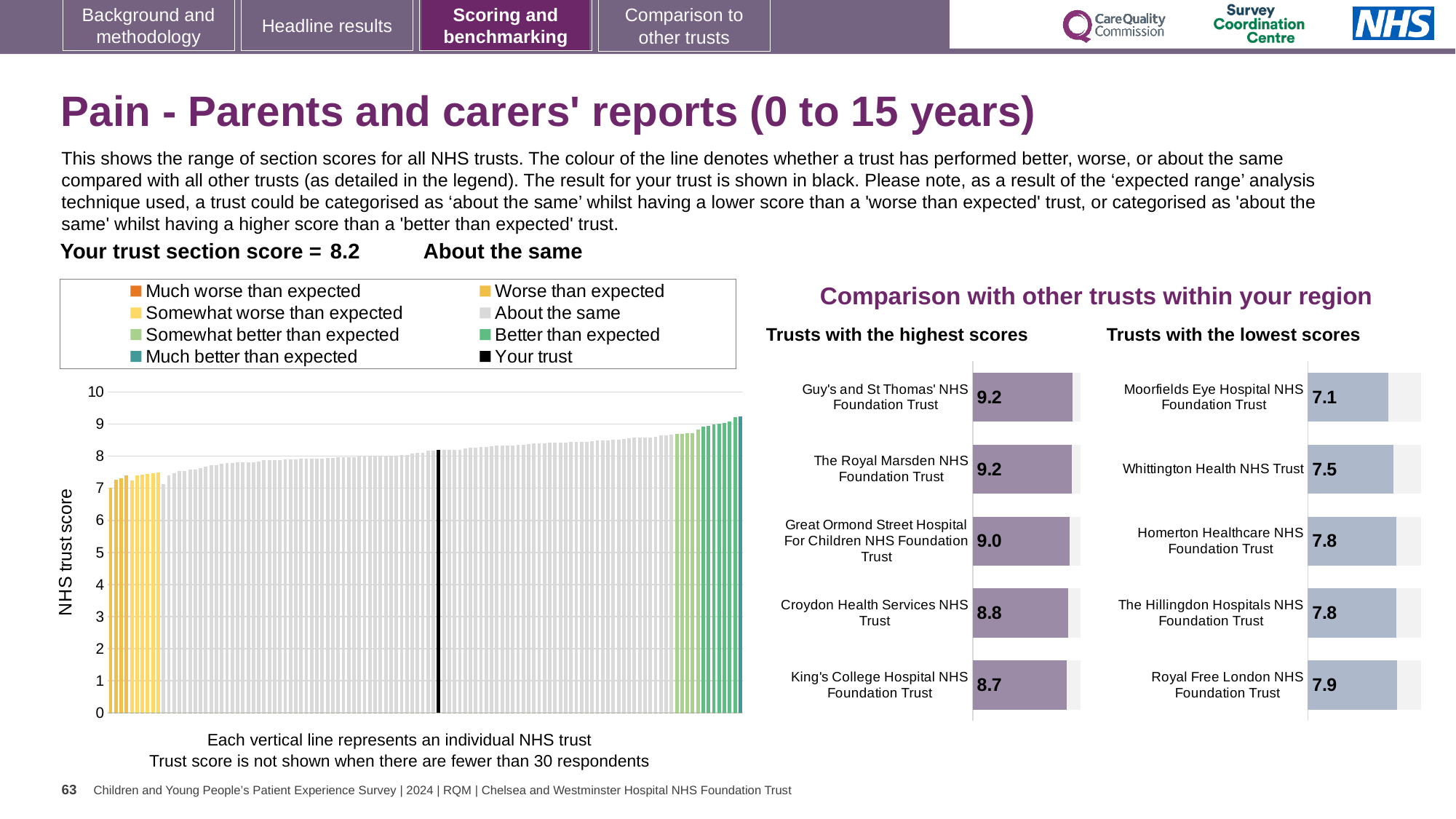
In the 'Trusts with the lowest scores' chart, what is the difference between the scores of Royal Free London NHS Foundation Trust and Moorfields Eye Hospital NHS Foundation Trust? 0.8 In the 'Trusts with the highest scores' chart, which trust has the lowest score? King's College Hospital NHS Foundation Trust In the 'Trusts with the highest scores' chart, what is the score for King's College Hospital NHS Foundation Trust? 8.7 How many trusts are shown in the 'Trusts with the highest scores' chart? 5 In the 'Trusts with the lowest scores' chart, which trust has the highest score? Royal Free London NHS Foundation Trust What is the label on the vertical axis of the main chart on the left? NHS trust score In the main chart on the left, do the trust scores rise or fall from left to right? Rise What kind of chart is the main chart on the left showing all NHS trusts? Bar chart How many entries does the legend of the main chart on the left list? 8 In the 'Trusts with the lowest scores' chart, what is the score for Moorfields Eye Hospital NHS Foundation Trust? 7.1 In the 'Trusts with the highest scores' chart, what is the score for Great Ormond Street Hospital For Children NHS Foundation Trust? 9.0 In the 'Trusts with the lowest scores' chart, which has the larger score: Whittington Health NHS Trust or Homerton Healthcare NHS Foundation Trust? Homerton Healthcare NHS Foundation Trust